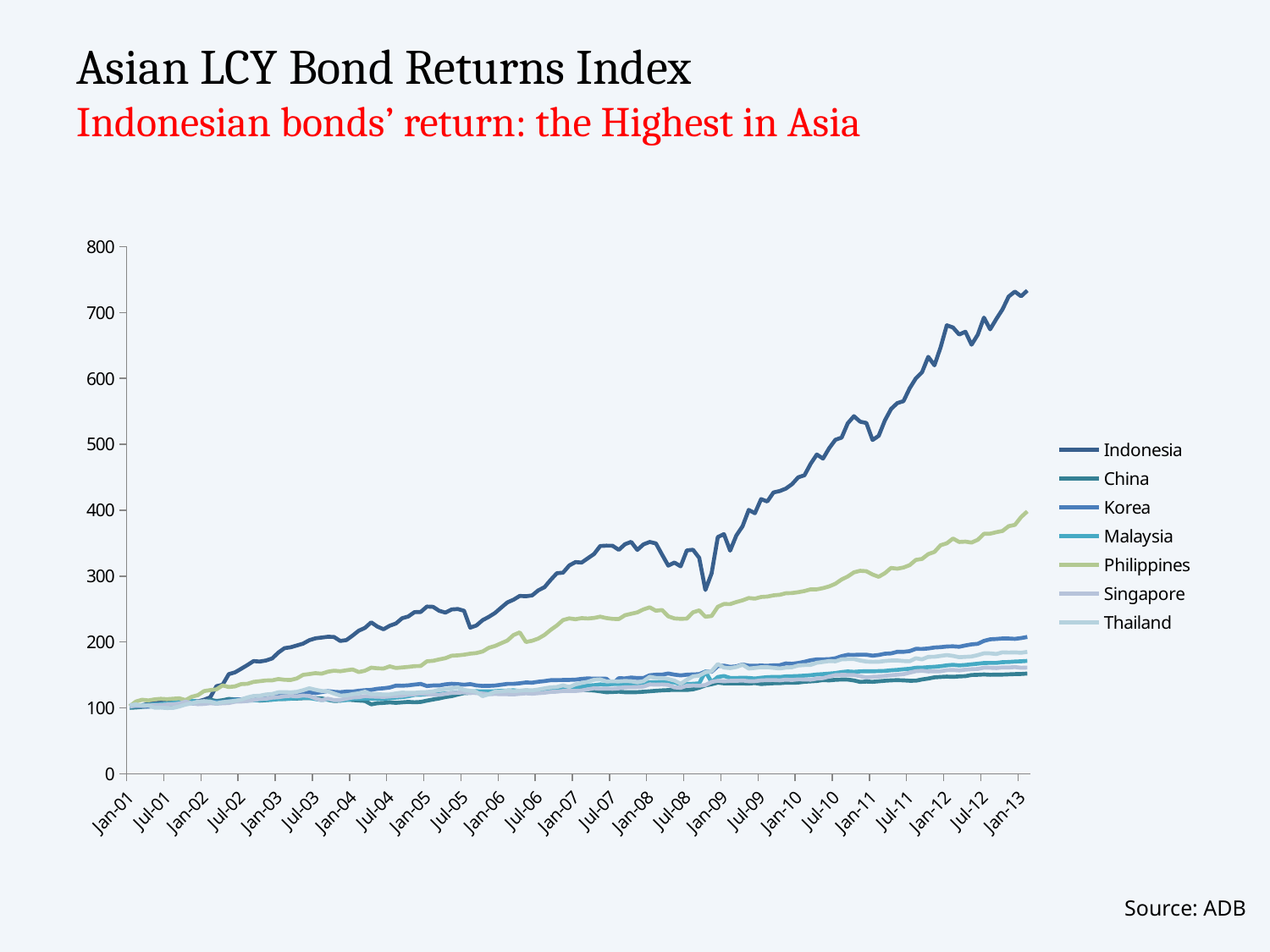
Is the value for Indonesia at Jan-08 greater or less than 300? greater Does the Indonesia series generally rise or fall from Jan-01 to Jan-13? rise Is the value for Indonesia at Jan-12 greater or less than 600? greater What is the title of the slide? Asian LCY Bond Returns Index Is the value for Philippines at Jan-13 greater or less than 300? greater What source is cited for the chart? ADB What kind of chart is shown on the slide? line chart Which is larger at Jan-13, the value for Indonesia or the value for Philippines? Indonesia Which series has the highest value at Jan-13? Indonesia How many series does the legend list? 7